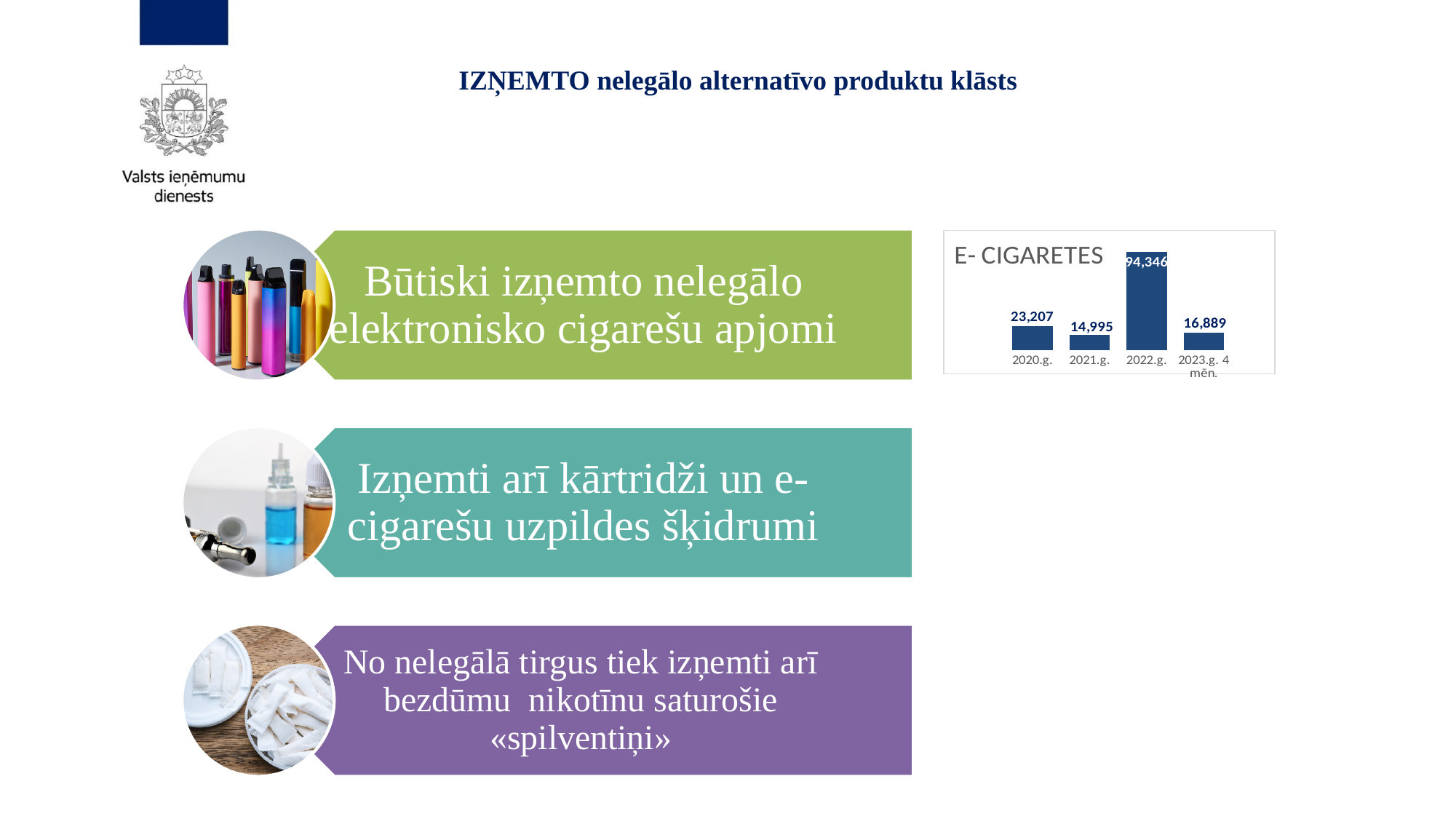
What is the difference between the 2020.g. and 2023.g. 4 mēn. values in the E- CIGARETES chart? 6,318 What is the title of the chart on the slide? E- CIGARETES What is the value for 2020.g. in the E- CIGARETES chart? 23,207 What is the value for 2023.g. 4 mēn. in the E- CIGARETES chart? 16,889 What is the value for 2022.g. in the E- CIGARETES chart? 94,346 How many categories are shown in the E- CIGARETES chart? 4 Which category has the lowest value in the E- CIGARETES chart? 2021.g. What is the difference between the 2022.g. and 2021.g. values in the E- CIGARETES chart? 79,351 What kind of chart is the E- CIGARETES chart? Bar chart What is the value for 2021.g. in the E- CIGARETES chart? 14,995 Which is larger in the E- CIGARETES chart, the value for 2020.g. or for 2023.g. 4 mēn.? 2020.g. Which category has the highest value in the E- CIGARETES chart? 2022.g.